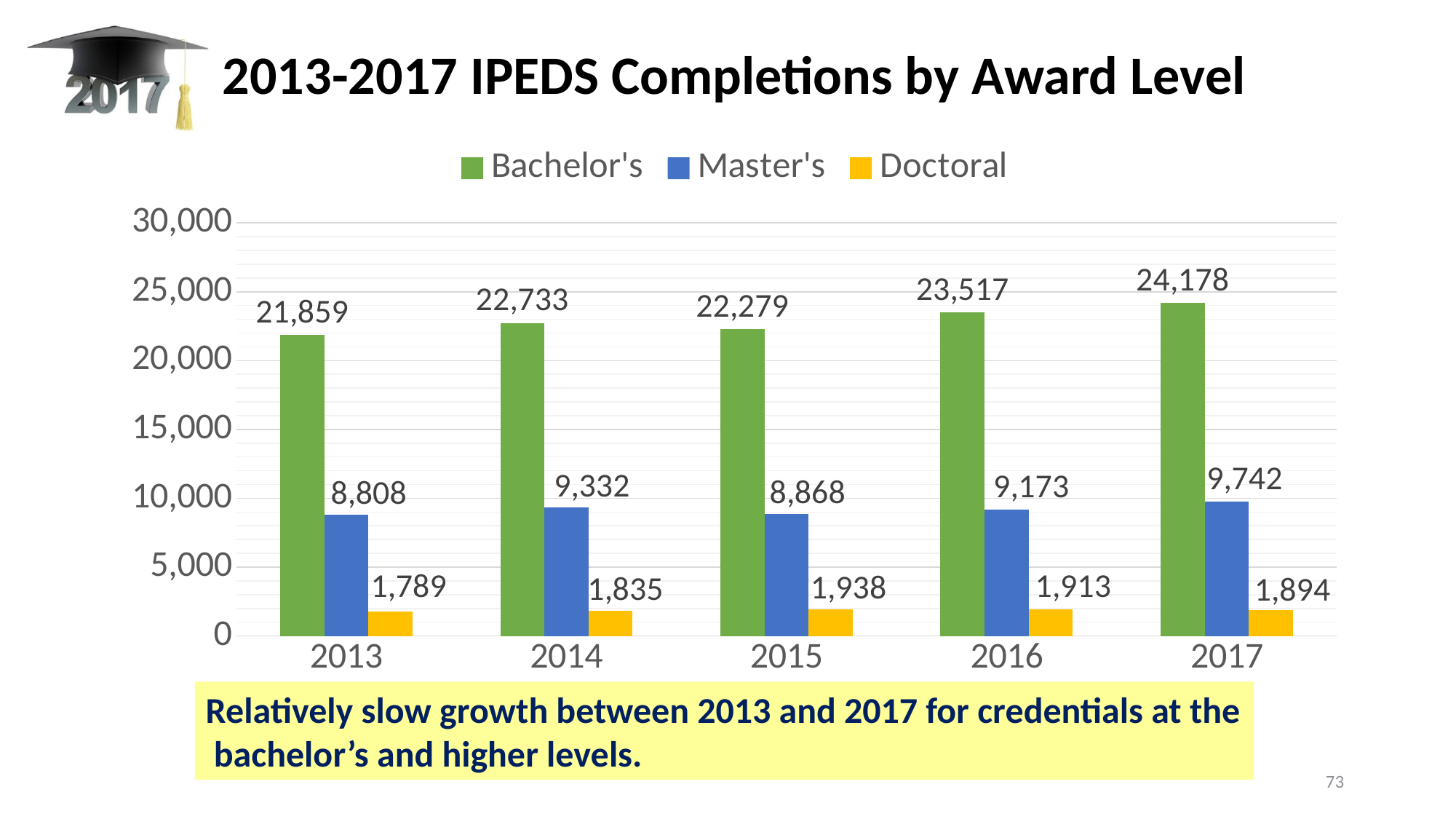
What kind of chart is shown on the slide? bar chart In which year is the Bachelor's value highest? 2017 What is the difference between the Bachelor's values for 2017 and 2013? 2,319 How many years are shown on the x axis? 5 How many series does the legend list? 3 Is the Bachelor's value for 2016 greater or less than 20,000? greater Which is larger, the Master's value for 2014 or the Master's value for 2016? 2014 In which year is the Master's value lowest? 2013 What is the Bachelor's value for 2015? 22,279 In which year is the Doctoral value highest? 2015 What is the Master's value for 2017? 9,742 What is the Doctoral value for 2013? 1,789